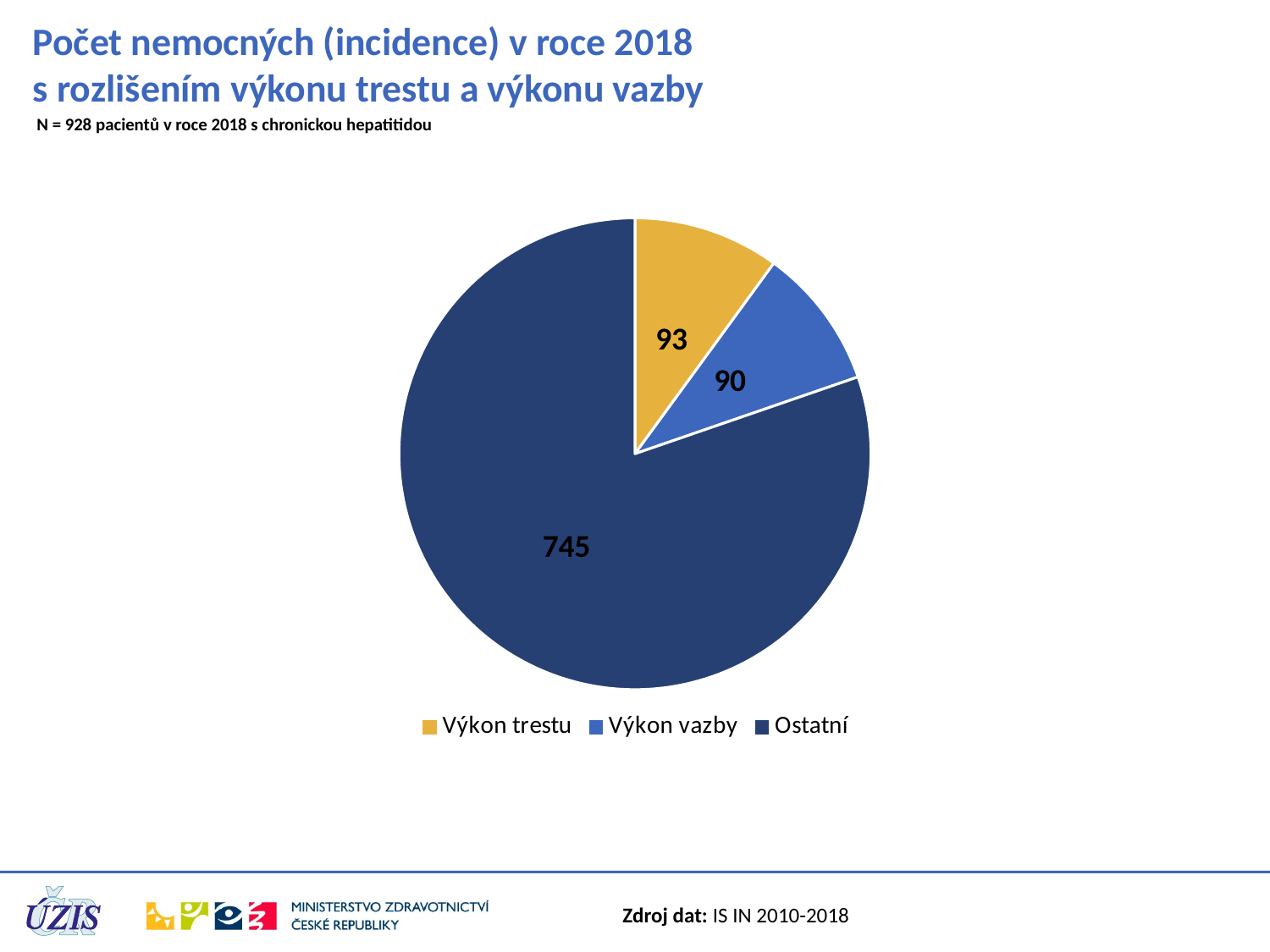
What is the value for Výkon trestu? 93 Which colour represents Výkon trestu in the legend? yellow/gold How many slices does the pie chart have? 3 What is the difference between the values for Výkon trestu and Výkon vazby? 3 Which is larger, the value for Výkon trestu or the value for Výkon vazby? Výkon trestu What is the value for Výkon vazby? 90 Which category has the smallest slice? Výkon vazby What is the value for Ostatní? 745 What is the total of all slices in the pie chart? 928 What type of chart is shown on the slide? pie chart What is the difference between the values for Ostatní and Výkon trestu? 652 Which category has the largest slice? Ostatní